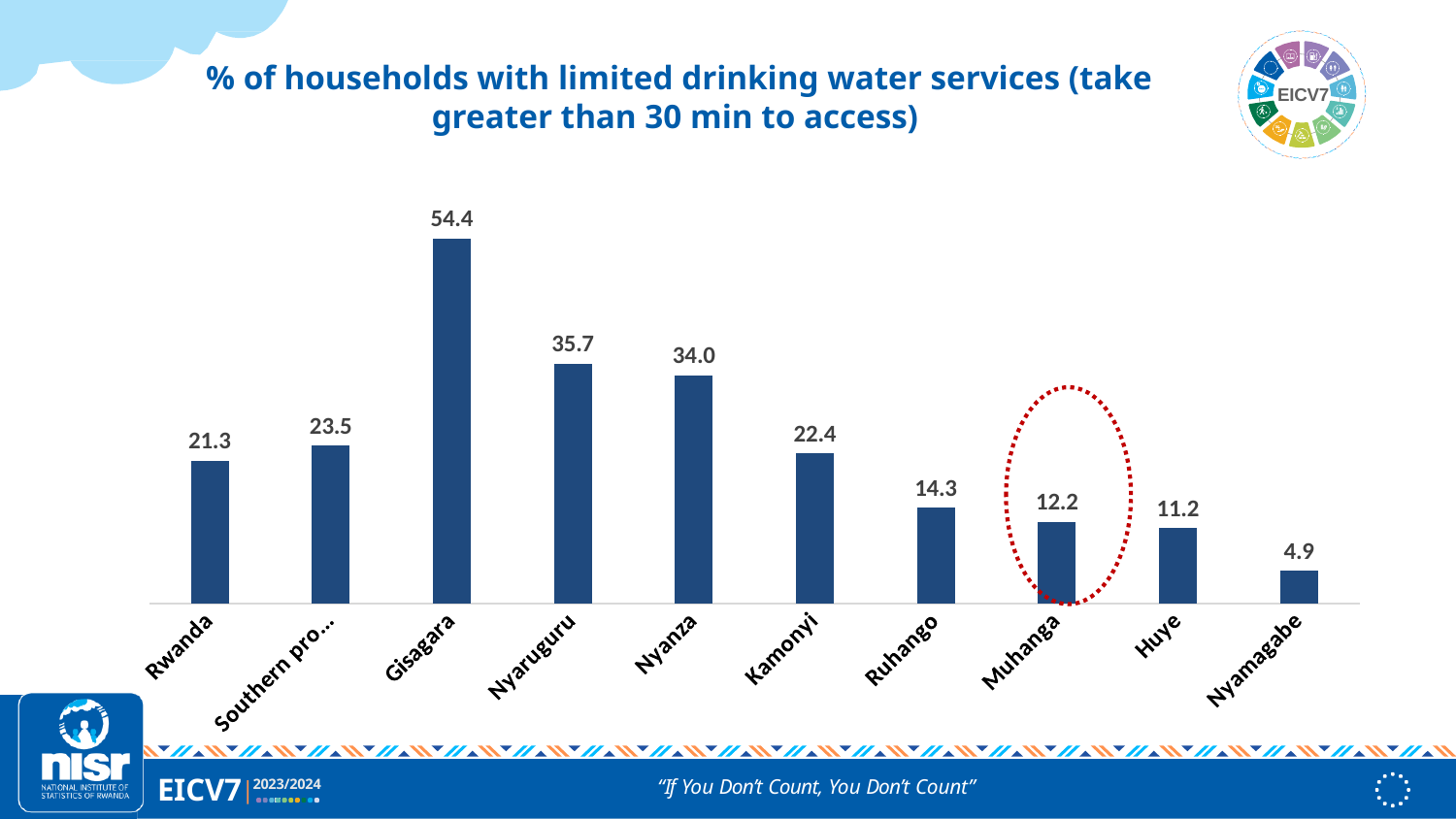
What is the difference between the values for Gisagara and Nyamagabe? 49.5 What is the value for Rwanda? 21.3 How many categories are shown on the x axis? 10 What is the difference between the values for Nyaruguru and Nyanza? 1.7 What kind of chart is shown on the slide? Bar chart Which category has the highest value? Gisagara Which is larger, the value for Rwanda or the value for Southern province? Southern province Which category has the lowest value? Nyamagabe What is the value for Muhanga, the category circled in red? 12.2 What is the value for Gisagara? 54.4 Which is larger, the value for Kamonyi or the value for Ruhango? Kamonyi What is the title of the chart? % of households with limited drinking water services (take greater than 30 min to access)